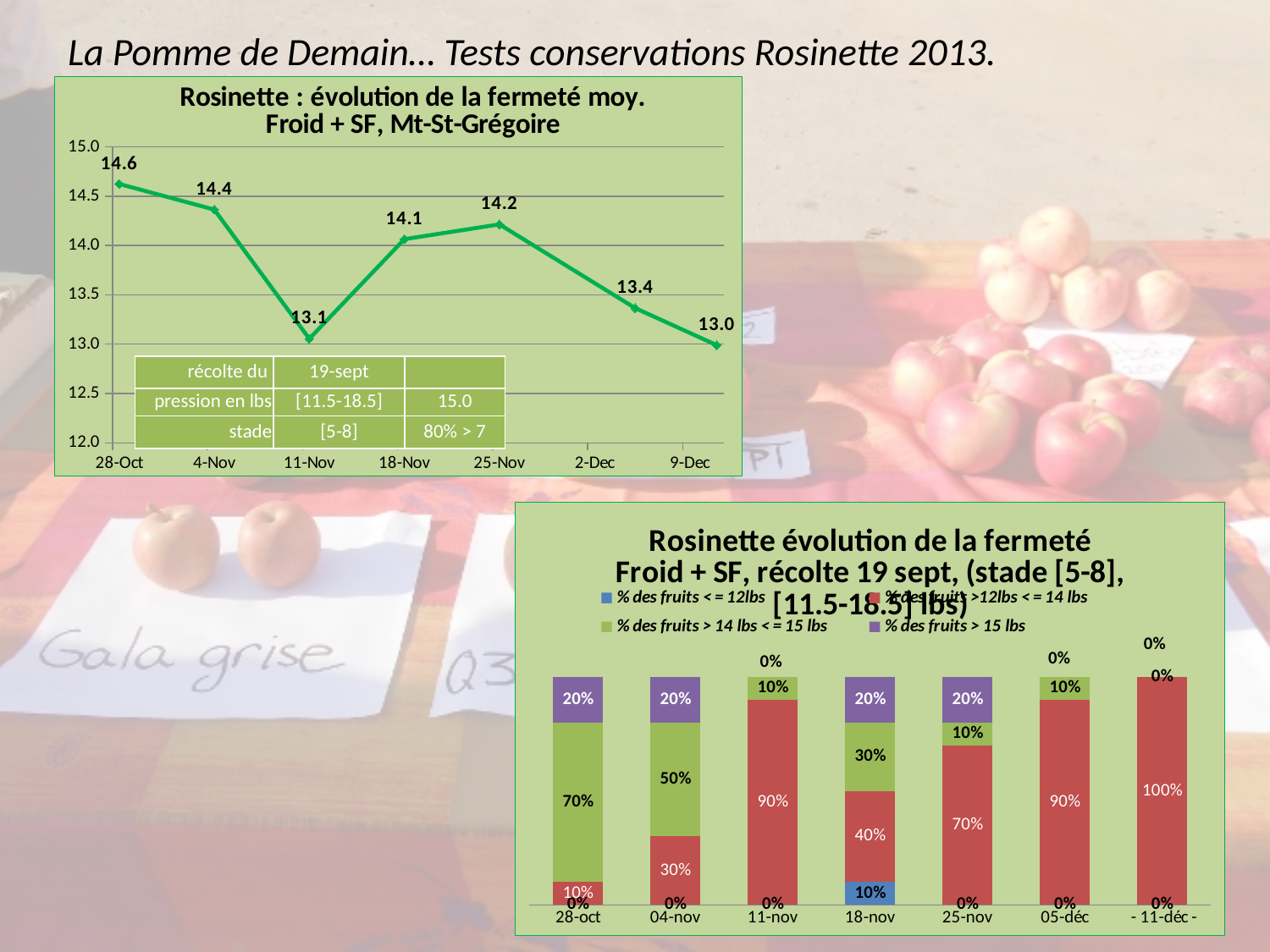
In the bottom-right stacked bar chart, how many series does the legend list? 4 In the top-left line chart, what is the value on 11-Nov? 13.1 In the top-left line chart, what is the difference between the values on 28-Oct and 9-Dec? 1.6 What type of chart is the top-left chart? Line chart In the bottom-right stacked bar chart, which is larger on 04-nov: the share of fruits >12lbs <= 14 lbs or the share > 14 lbs <= 15 lbs? > 14 lbs <= 15 lbs In the top-left line chart, what is the average firmness value on 28-Oct? 14.6 In the top-left line chart, which date has the highest firmness value? 28-Oct In the bottom-right stacked bar chart, what percentage of fruits is > 14 lbs <= 15 lbs on 28-oct? 70% In the bottom-right stacked bar chart, what percentage of fruits is >12lbs <= 14 lbs on 11-déc? 100% In the top-left line chart, how many data points are plotted? 7 In the bottom-right stacked bar chart, what is the percentage of fruits <= 12lbs on 18-nov? 10% In the top-left line chart, which date has the lowest firmness value? 9-Dec